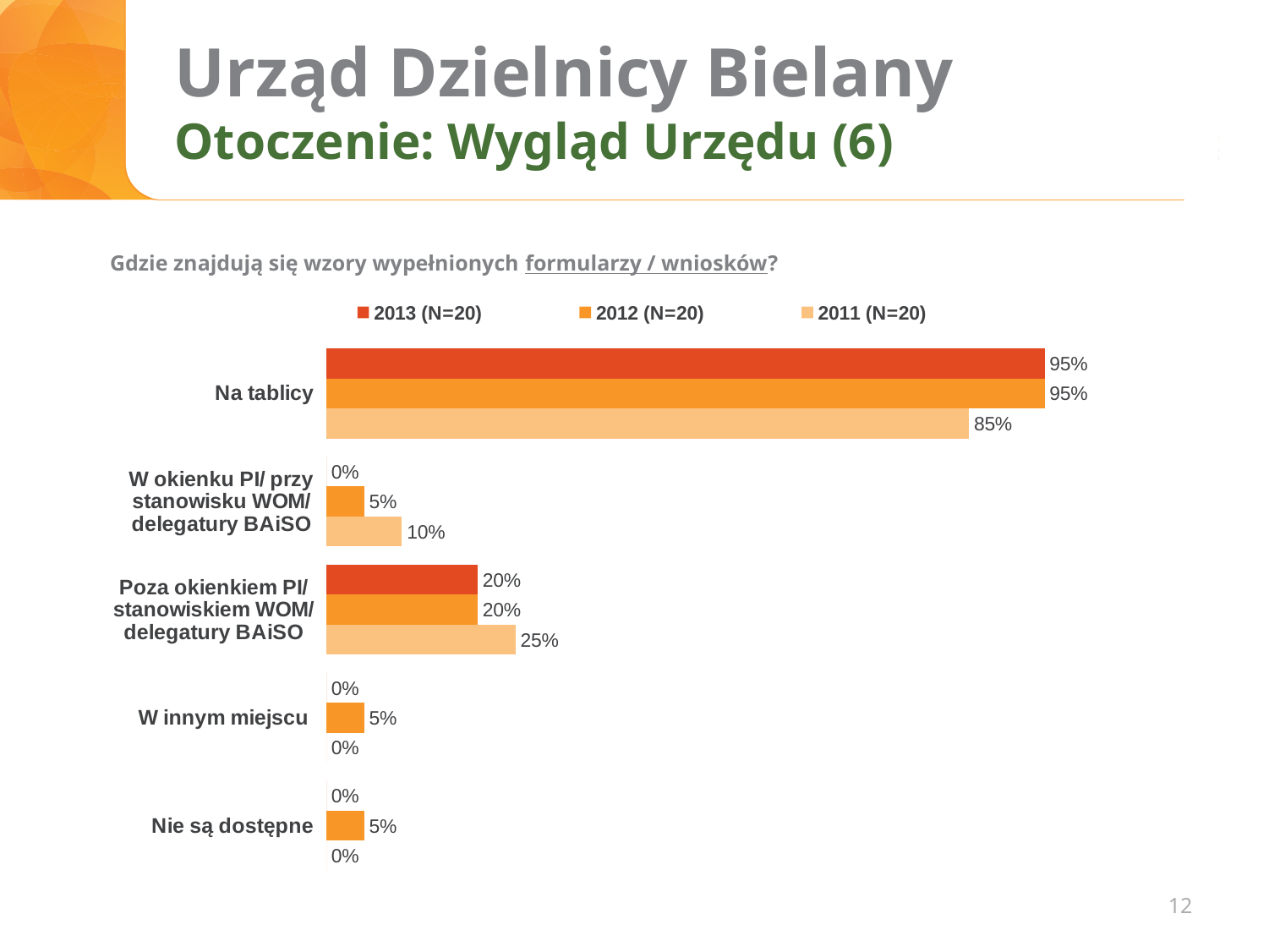
What is the value for "Poza okienkiem PI/ stanowiskiem WOM/ delegatury BAiSO" in the 2011 (N=20) series? 25% What is the value for "W okienku PI/ przy stanowisku WOM/ delegatury BAiSO" in the 2012 (N=20) series? 5% What kind of chart is shown on the slide? Bar chart How many categories are shown on the chart? 5 What is the value for "Na tablicy" in the 2011 (N=20) series? 85% What question does the chart answer, as stated above it? Gdzie znajdują się wzory wypełnionych formularzy / wniosków? Which is larger for "W okienku PI/ przy stanowisku WOM/ delegatury BAiSO": the 2011 (N=20) value or the 2012 (N=20) value? 2011 (N=20) What is the value for "Na tablicy" in the 2013 (N=20) series? 95% What is the difference between the 2013 (N=20) and 2011 (N=20) values for "Na tablicy"? 10% What is the difference between the 2011 (N=20) and 2012 (N=20) values for "Poza okienkiem PI/ stanowiskiem WOM/ delegatury BAiSO"? 5% Which category has the highest value in the 2013 (N=20) series? Na tablicy How many series does the legend list? 3